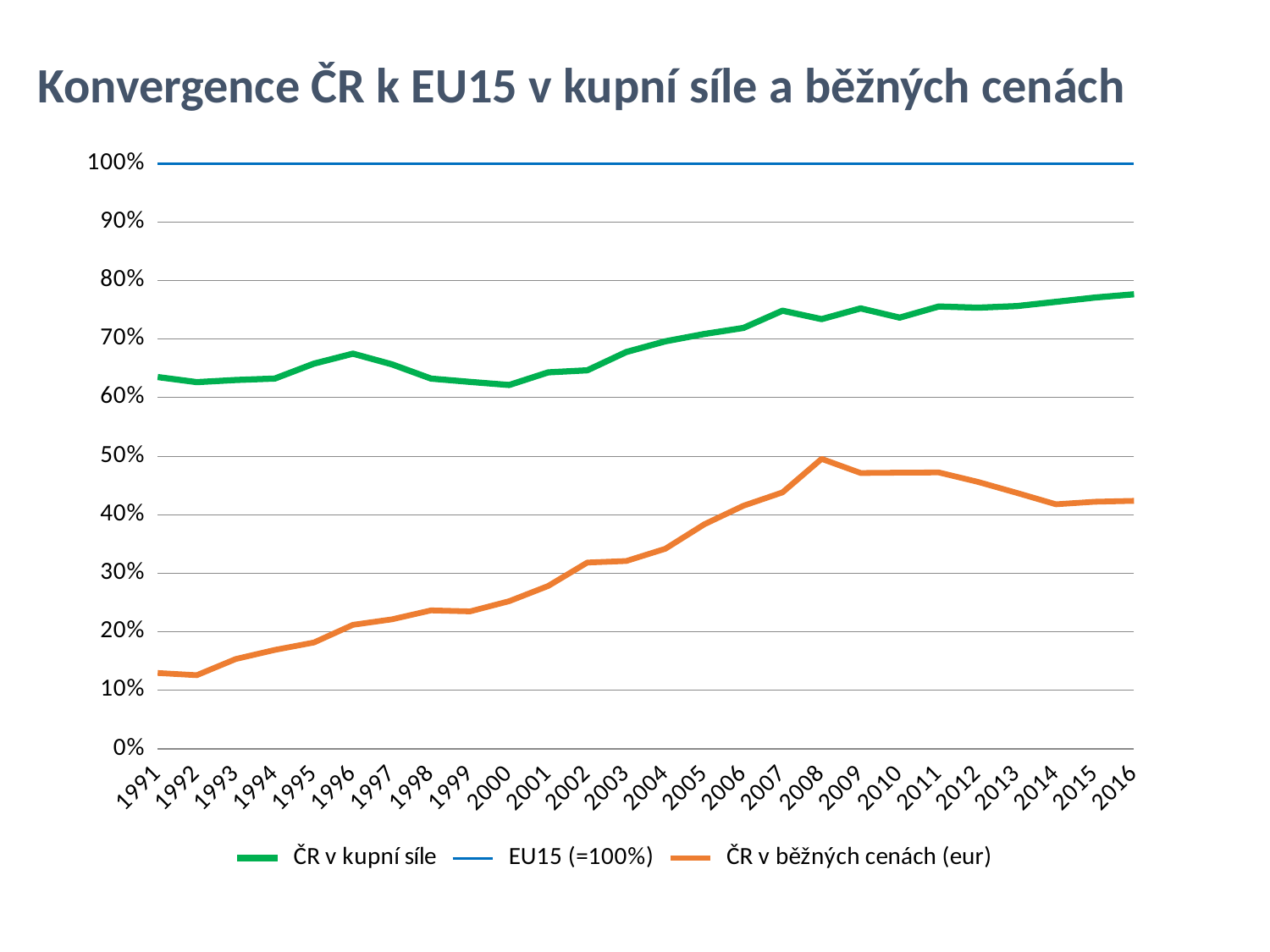
How many series does the legend list? 3 In which year is ČR v běžných cenách (eur) at its highest? 2008 Is the value for ČR v kupní síle in 1991 greater or less than 60%? greater Is the value for ČR v běžných cenách (eur) in 2008 greater or less than 40%? greater Is the value for ČR v kupní síle in 2016 greater or less than 70%? greater In 2008, which series is higher: ČR v kupní síle or ČR v běžných cenách (eur)? ČR v kupní síle Does ČR v běžných cenách (eur) rise or fall from 1991 to 2008? rise What value does the EU15 (=100%) line sit at? 100% What colour is the ČR v kupní síle line? green How many years are shown on the x axis? 26 What kind of chart is shown on the slide? line chart